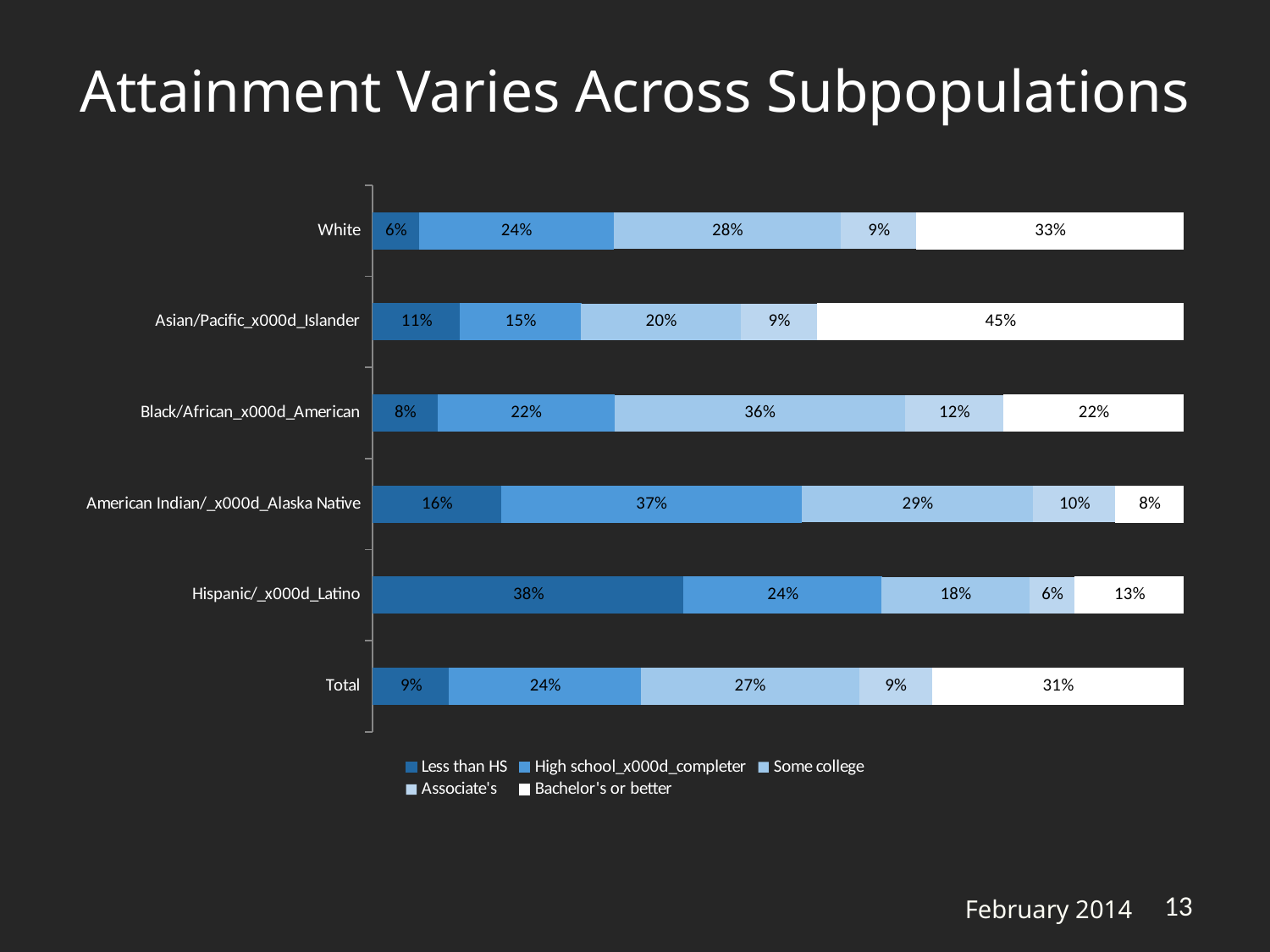
What is the Less than HS value for Hispanic/Latino? 38% What is the difference between the Bachelor's or better values for White and American Indian/Alaska Native? 25% How many subpopulation categories (bars) are shown in the chart? 6 Which category has the highest Bachelor's or better value? Asian/Pacific Islander What is the Bachelor's or better value for Asian/Pacific Islander? 45% What is the Some college value for Black/African American? 36% Which category has the lowest Less than HS value? White What kind of chart is shown on the slide? Stacked bar chart How many series does the legend list? 5 What is the Associate's value for the Total bar? 9% Which is larger: the High school completer value for American Indian/Alaska Native or for Asian/Pacific Islander? American Indian/Alaska Native What is the title of the chart slide? Attainment Varies Across Subpopulations